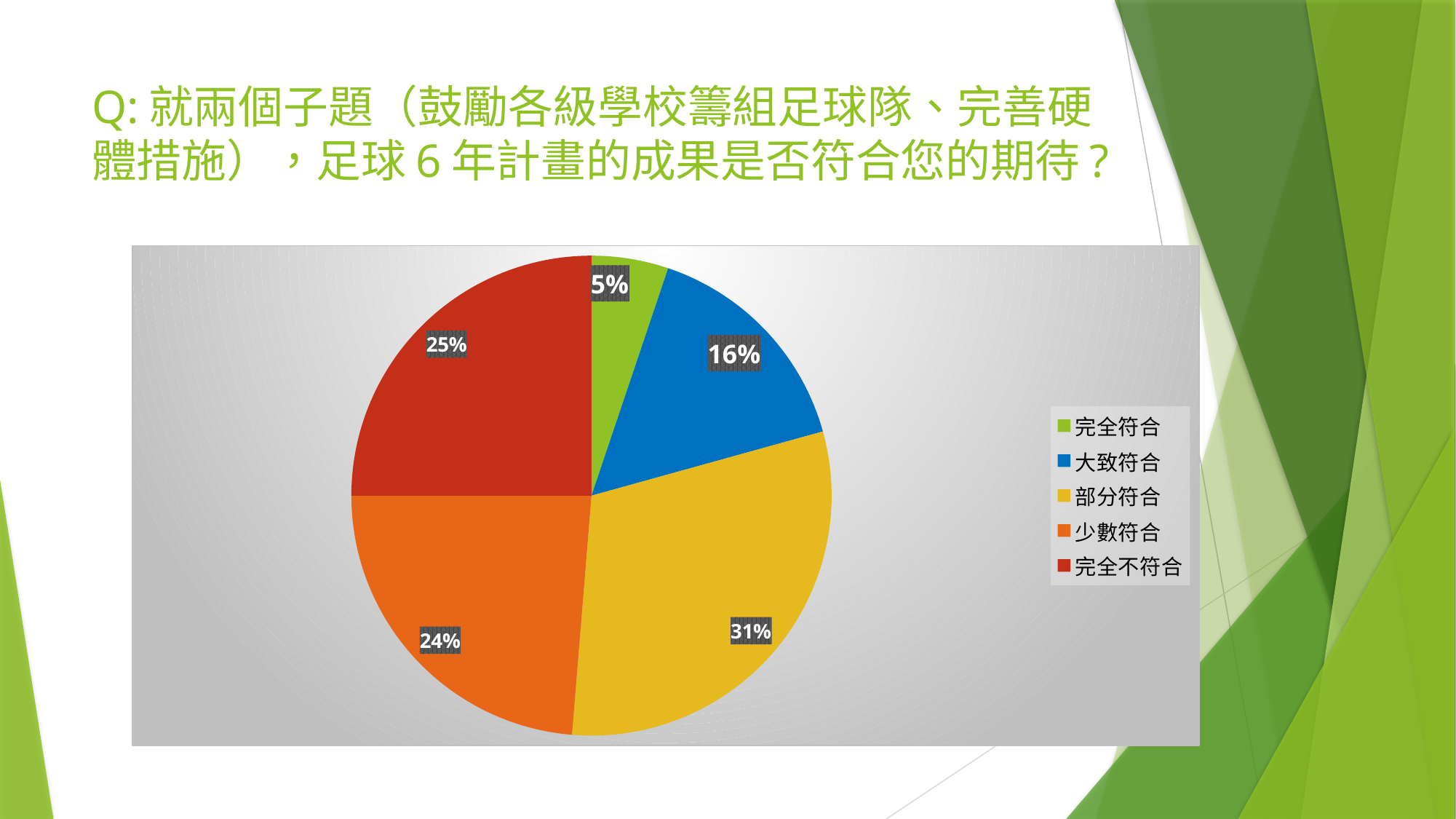
Which response category has the largest share of the pie? 部分符合 How many categories does the pie chart show? 5 What percentage of respondents answered 大致符合? 16% What percentage of respondents answered 部分符合? 31% What colour is the slice for 部分符合? Yellow What percentage of respondents answered 少數符合? 24% What type of chart is shown on the slide? Pie chart What percentage of respondents answered 完全不符合? 25% What is the difference in percentage points between 部分符合 and 大致符合? 15 Which is larger, the share for 大致符合 or the share for 完全不符合? 完全不符合 What percentage of respondents answered 完全符合? 5% Which response category has the smallest share of the pie? 完全符合